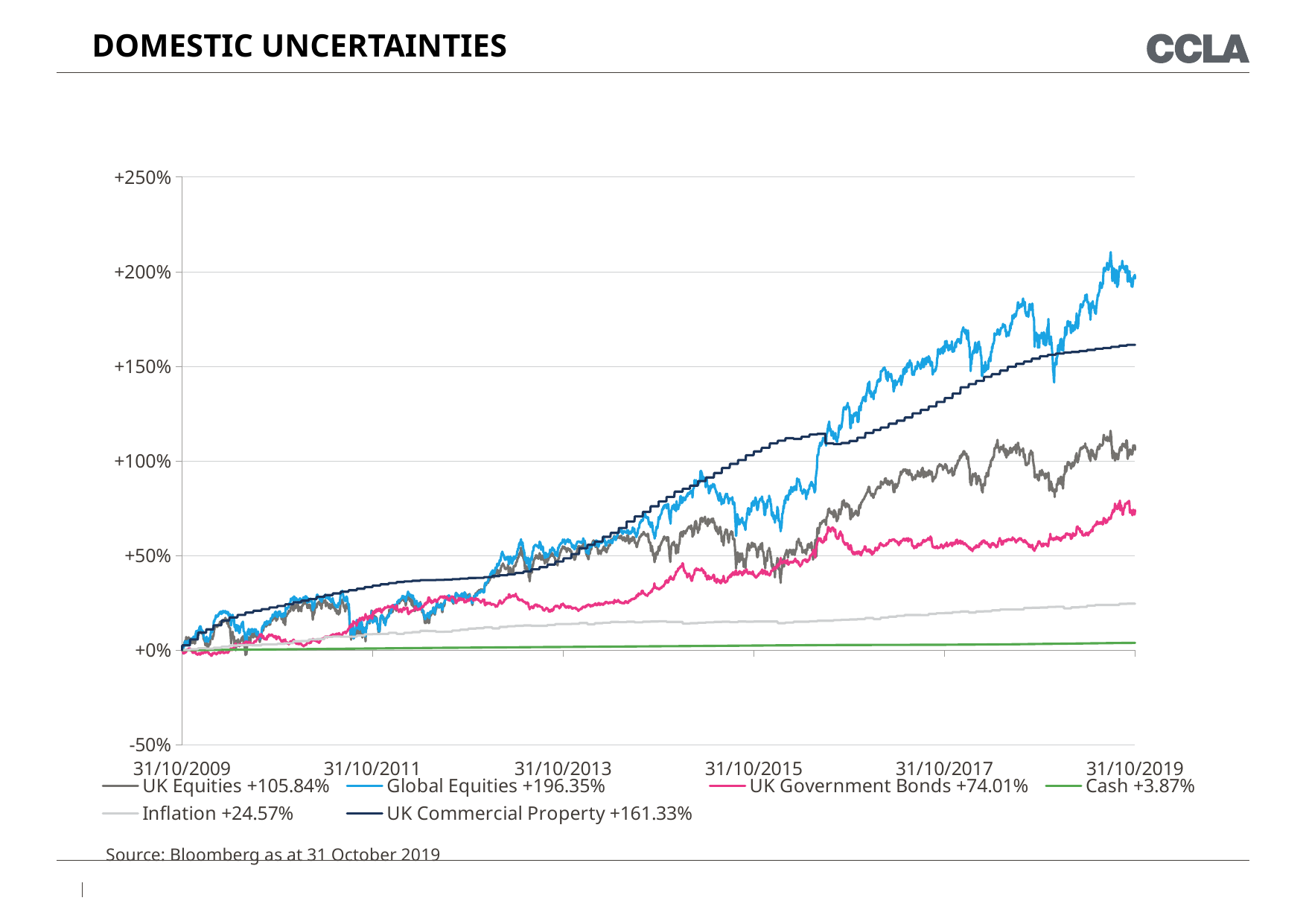
What cumulative return does the legend give for Global Equities? +196.35% Which series has the highest cumulative return shown in the legend? Global Equities Does the UK Commercial Property line generally rise or fall from 31/10/2009 to 31/10/2019? rise What is the title of the slide? DOMESTIC UNCERTAINTIES Which series has the lowest cumulative return shown in the legend? Cash What kind of chart is shown on the slide? line chart Which has the larger legend return, Inflation or UK Government Bonds? UK Government Bonds What is the difference between the legend returns for UK Equities and UK Government Bonds? 31.83% What cumulative return does the legend give for UK Commercial Property? +161.33% What cumulative return does the legend give for Cash? +3.87% Is the value of the UK Commercial Property line at 31/10/2019 greater or less than +150%? greater How many series does the legend list? 6